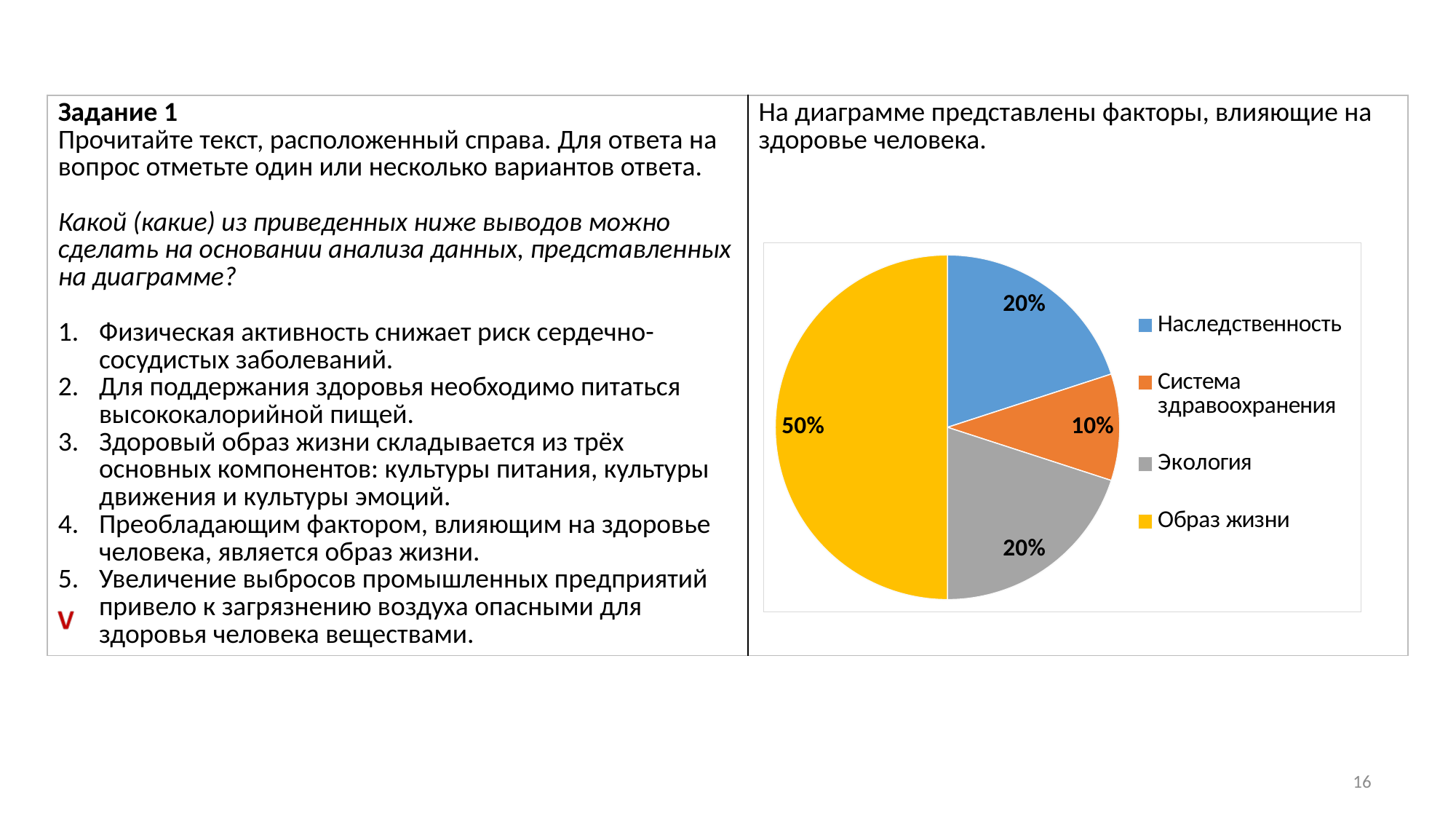
What share of the pie does Образ жизни have? 50% What is the difference between the shares of Образ жизни and Экология? 30% Which category has the smallest slice of the pie? Система здравоохранения What share of the pie does Экология have? 20% Which is larger, the share of Наследственность or the share of Система здравоохранения? Наследственность What share of the pie does Система здравоохранения have? 10% Which category has the largest slice of the pie? Образ жизни Which legend entry is shown in orange? Система здравоохранения What kind of chart is shown on the slide? pie chart What colour is the slice for Образ жизни? yellow How many categories does the pie chart show? 4